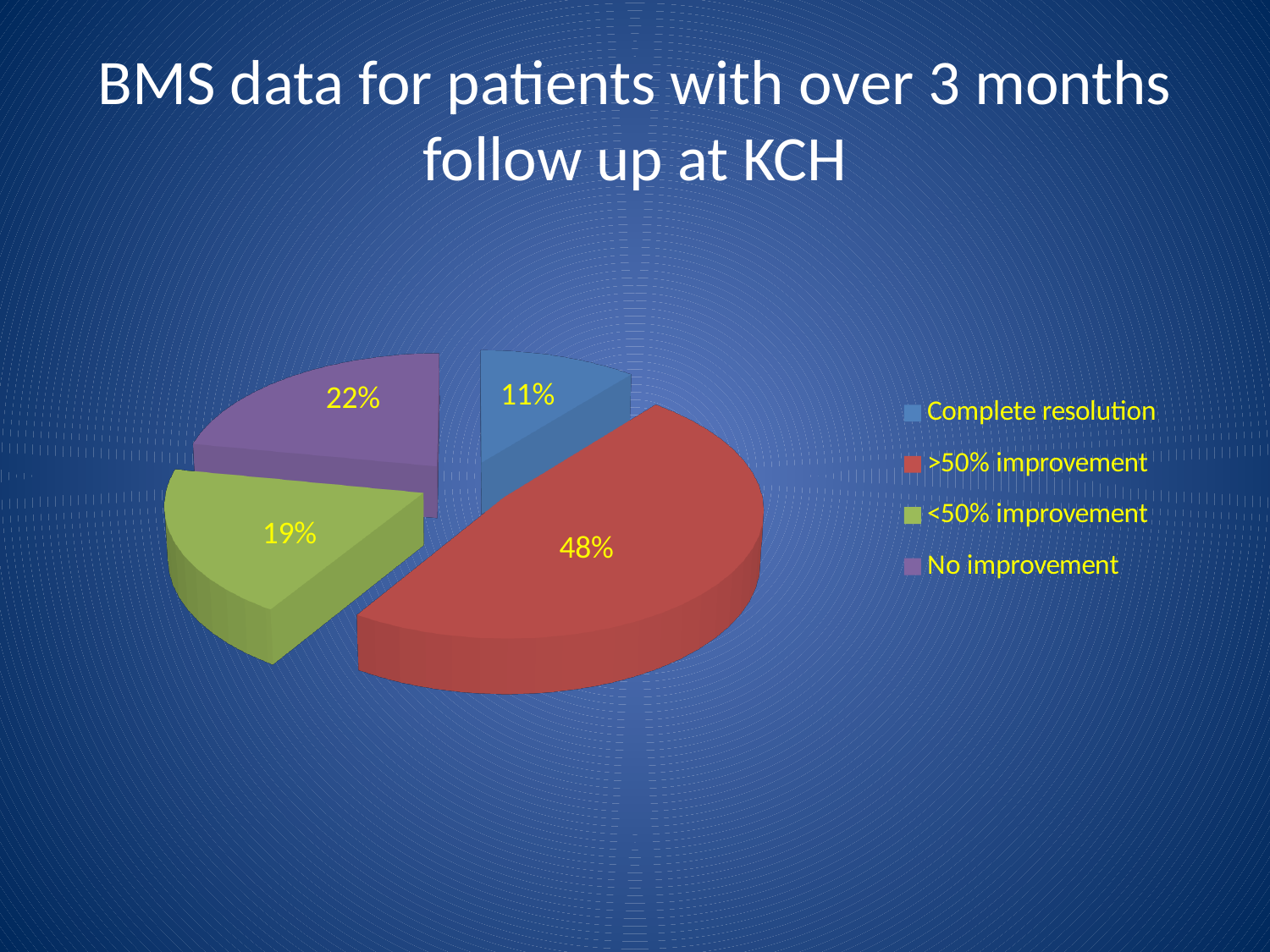
Which is larger: the share for no improvement or the share for <50% improvement? No improvement What is the difference in percentage points between >50% improvement and no improvement? 26 What percentage of patients had >50% improvement? 48% What kind of chart is shown on the slide? Pie chart How many slices does the pie chart have? 4 Which category has the smallest share of the pie? Complete resolution Which category has the largest share of the pie? >50% improvement How many entries does the legend list? 4 What percentage of patients had no improvement? 22% What colour is the slice for >50% improvement? Red What percentage of patients had <50% improvement? 19% What percentage of patients had complete resolution? 11%